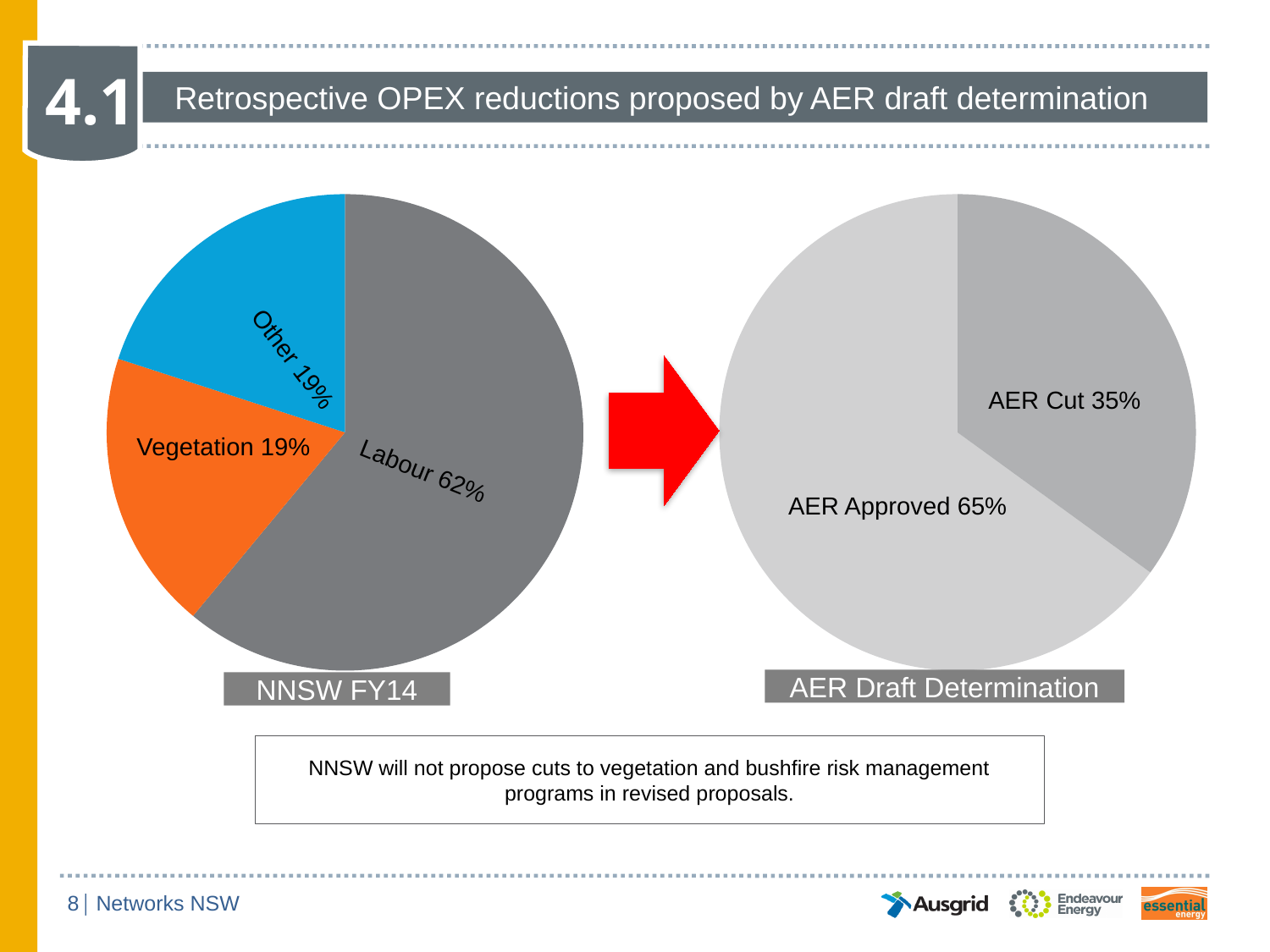
In the AER Draft Determination chart, which slice is larger, AER Cut or AER Approved? AER Approved In the AER Draft Determination chart, what share is AER Approved? 65% In the NNSW FY14 chart, what share does Labour account for? 62% In the NNSW FY14 chart, what colour is the Vegetation slice? Orange In the AER Draft Determination chart, what is the difference between AER Approved and AER Cut? 30 percentage points In the NNSW FY14 chart, what is the difference between the Labour share and the Vegetation share? 43 percentage points What type of chart is the AER Draft Determination chart? Pie chart In the NNSW FY14 chart, what share does Vegetation account for? 19% How many slices does the NNSW FY14 chart have? 3 In the NNSW FY14 chart, what share does Other account for? 19% In the NNSW FY14 chart, which category has the largest slice? Labour In the AER Draft Determination chart, what share is AER Cut? 35%